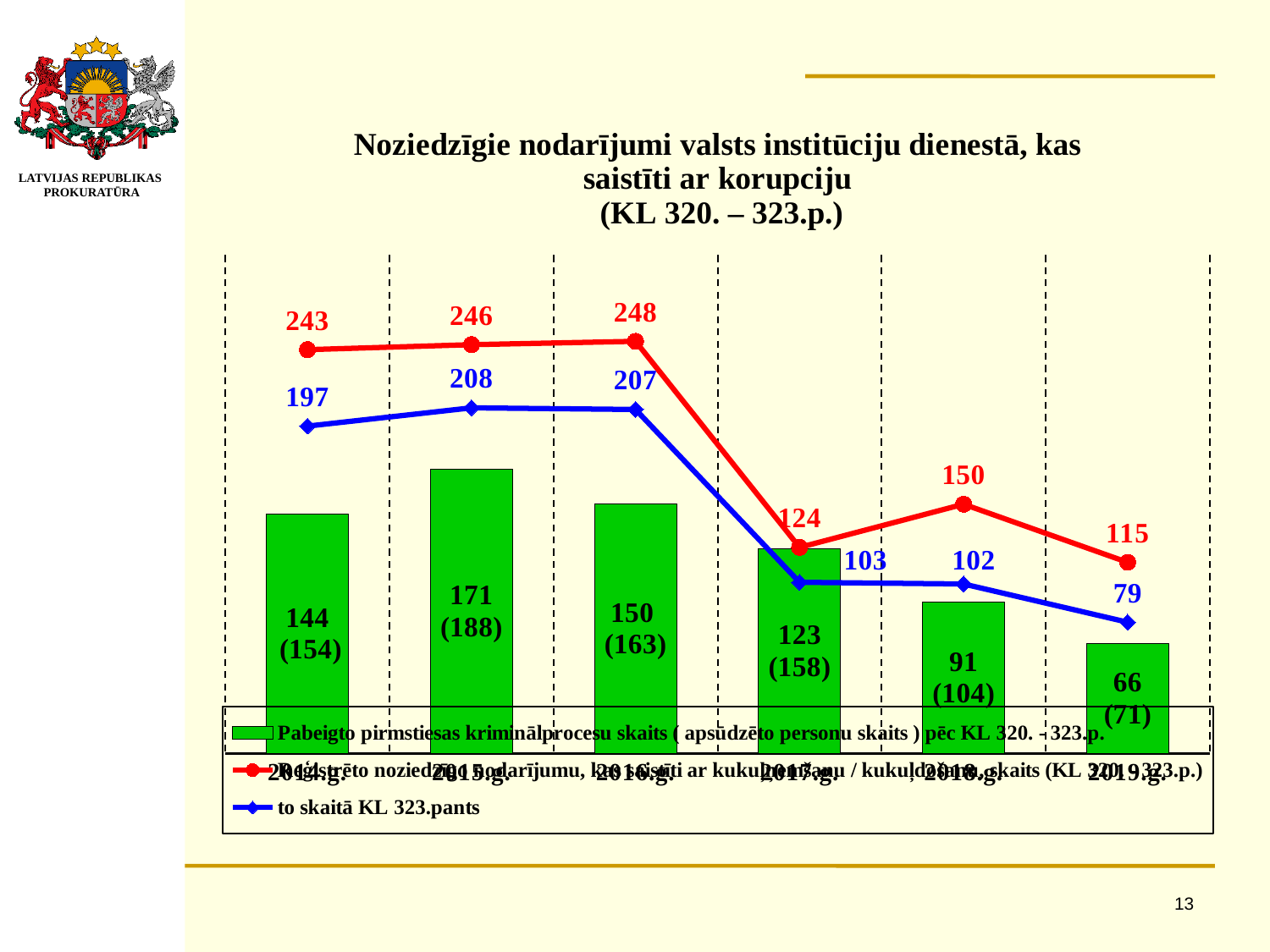
What is the value of the blue line (to skaitā KL 323.pants) for 2019.g.? 79 What is the value of the red line (registered offences, KL 320.-323.p.) for 2016.g.? 248 In which year does the red line reach its highest value? 2016.g. In which year is the green bar the lowest? 2019.g. How many series does the legend list? 3 What kind of chart is shown on the slide? A combined bar and line chart For 2018.g., which is larger: the red line value or the blue line value? The red line value (150) Does the blue line rise or fall from 2016.g. to 2019.g.? It falls How many years are shown on the x axis? 6 What is the difference between the first number on the green bar for 2015.g. and the first number on the green bar for 2014.g.? 27 By how much does the red line value drop from 2016.g. to 2017.g.? 124 What label is printed on the green bar for 2015.g.? 171 (188)